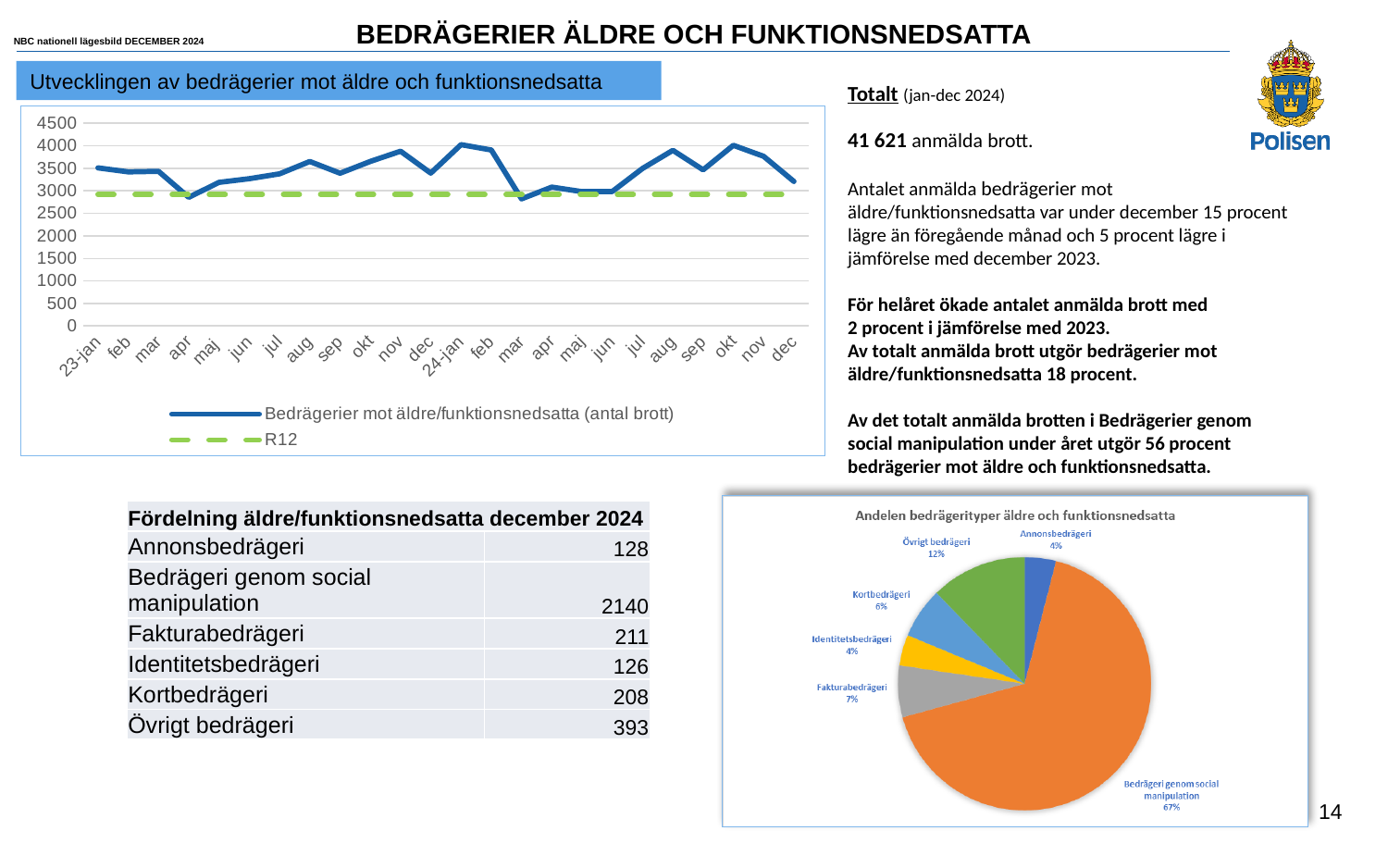
In the chart "Utvecklingen av bedrägerier mot äldre och funktionsnedsatta", is the value of the solid line for 24-jan greater or less than 3500? greater In the chart "Utvecklingen av bedrägerier mot äldre och funktionsnedsatta", is the value of the solid line for the last point (dec 2024) greater or less than 3500? less In the pie chart "Andelen bedrägerityper äldre och funktionsnedsatta", which is larger, Fakturabedrägeri or Kortbedrägeri? Fakturabedrägeri In the pie chart "Andelen bedrägerityper äldre och funktionsnedsatta", which category has the largest slice? Bedrägeri genom social manipulation In the chart "Utvecklingen av bedrägerier mot äldre och funktionsnedsatta", what is the name of the dashed green series in the legend? R12 What kind of chart is the chart titled "Andelen bedrägerityper äldre och funktionsnedsatta"? Pie chart In the pie chart "Andelen bedrägerityper äldre och funktionsnedsatta", what is the percentage shown for Övrigt bedrägeri? 12% In the pie chart "Andelen bedrägerityper äldre och funktionsnedsatta", what is the difference in percentage points between Övrigt bedrägeri and Fakturabedrägeri? 5 percentage points In the pie chart "Andelen bedrägerityper äldre och funktionsnedsatta", how many slices are there? 6 In the chart "Utvecklingen av bedrägerier mot äldre och funktionsnedsatta", how many series does the legend list? 2 In the pie chart "Andelen bedrägerityper äldre och funktionsnedsatta", what share does Bedrägeri genom social manipulation have? 67% What kind of chart is the chart titled "Utvecklingen av bedrägerier mot äldre och funktionsnedsatta"? Line chart